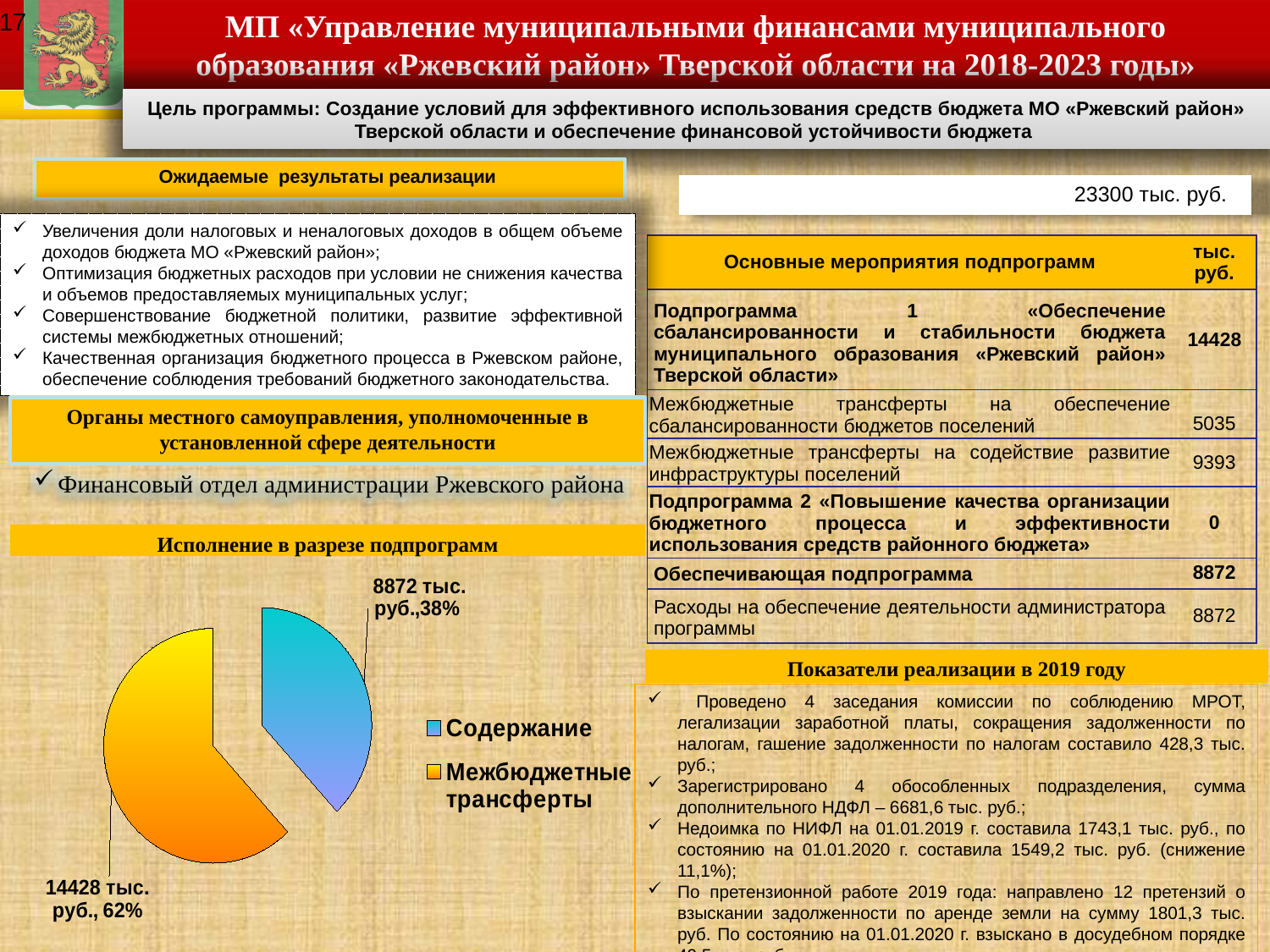
Which slice of the pie chart is the largest? Межбюджетные трансферты How many slices does the pie chart have? 2 What is the difference in thousand rubles between the 'Межбюджетные трансферты' and 'Содержание' slices? 5556 тыс. руб. What is the value shown for the 'Содержание' slice of the pie chart? 8872 тыс. руб. How many entries does the legend of the pie chart list? 2 What kind of chart is shown on the slide? pie chart What is the title of the pie chart section on the slide? Исполнение в разрезе подпрограмм What share of the pie does 'Межбюджетные трансферты' represent? 62% What share of the pie does 'Содержание' represent? 38% Which is larger in the pie chart: 'Содержание' or 'Межбюджетные трансферты'? Межбюджетные трансферты Which slice of the pie chart is the smallest? Содержание What is the value shown for the 'Межбюджетные трансферты' slice of the pie chart? 14428 тыс. руб.